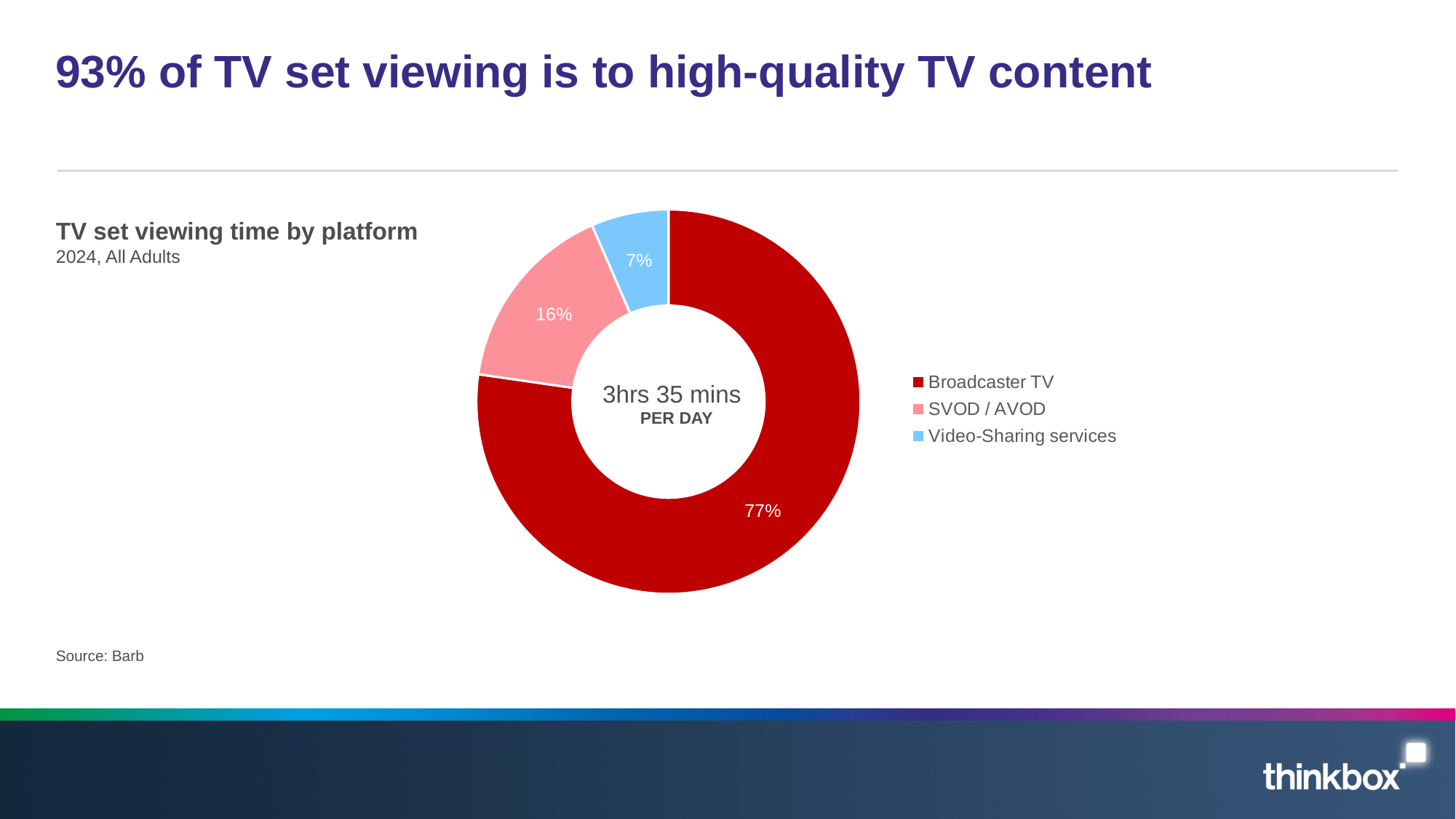
What is the difference in percentage points between the SVOD / AVOD share and the Video-Sharing services share? 9 What kind of chart is shown on the slide? Doughnut chart Which has a larger share of TV set viewing time, SVOD / AVOD or Video-Sharing services? SVOD / AVOD What share of TV set viewing time is SVOD / AVOD? 16% What share of TV set viewing time is Video-Sharing services? 7% Which platform has the smallest share of TV set viewing time? Video-Sharing services What share of TV set viewing time is Broadcaster TV? 77% What is the total daily TV set viewing time shown in the centre of the chart? 3hrs 35 mins What is the difference in percentage points between the Broadcaster TV share and the SVOD / AVOD share? 61 Which platform has the largest share of TV set viewing time? Broadcaster TV How many platforms are shown in the chart? 3 What is the title of the chart? TV set viewing time by platform